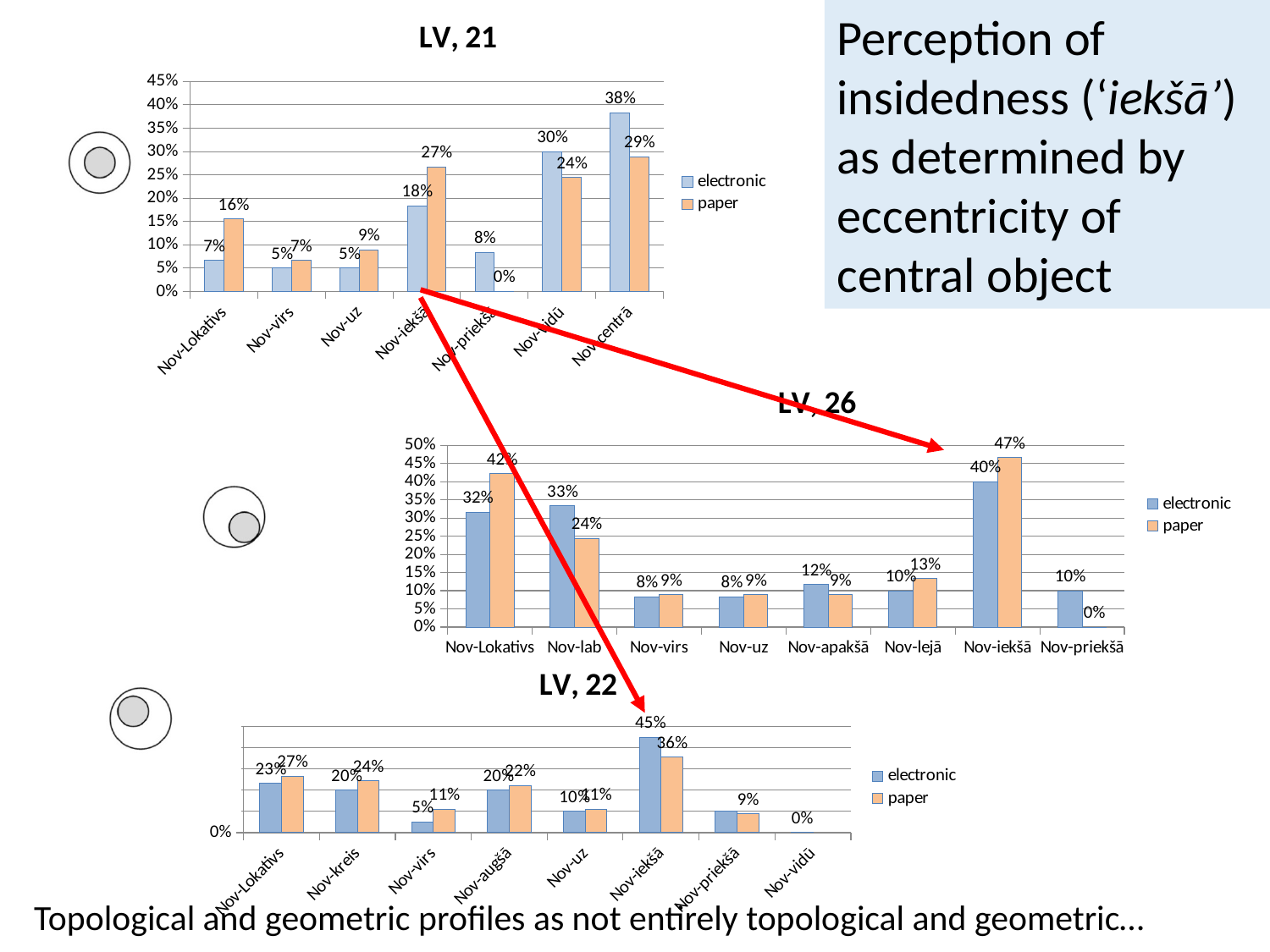
In the chart titled 'LV, 21', what is the electronic value for Nov-centrā? 38% How many series does the legend list in the chart titled 'LV, 22'? 2 What type of chart is the chart titled 'LV, 21'? bar chart In the chart titled 'LV, 21', what is the difference between the paper and electronic values for Nov-Lokatīvs? 9% In the chart titled 'LV, 21', what is the paper value for Nov-iekšā? 27% In the chart titled 'LV, 22', what is the difference between the electronic and paper values for Nov-iekšā? 9% In the chart titled 'LV, 26', which is larger for Nov-lab: the electronic value or the paper value? electronic In the chart titled 'LV, 22', what is the electronic value for Nov-iekšā? 45% In the chart titled 'LV, 21', which category has the highest electronic value? Nov-centrā In the chart titled 'LV, 26', how many categories are shown on the x axis? 8 In the chart titled 'LV, 26', what is the paper value for Nov-iekšā? 47% In the chart titled 'LV, 26', which category has the lowest paper value? Nov-priekšā